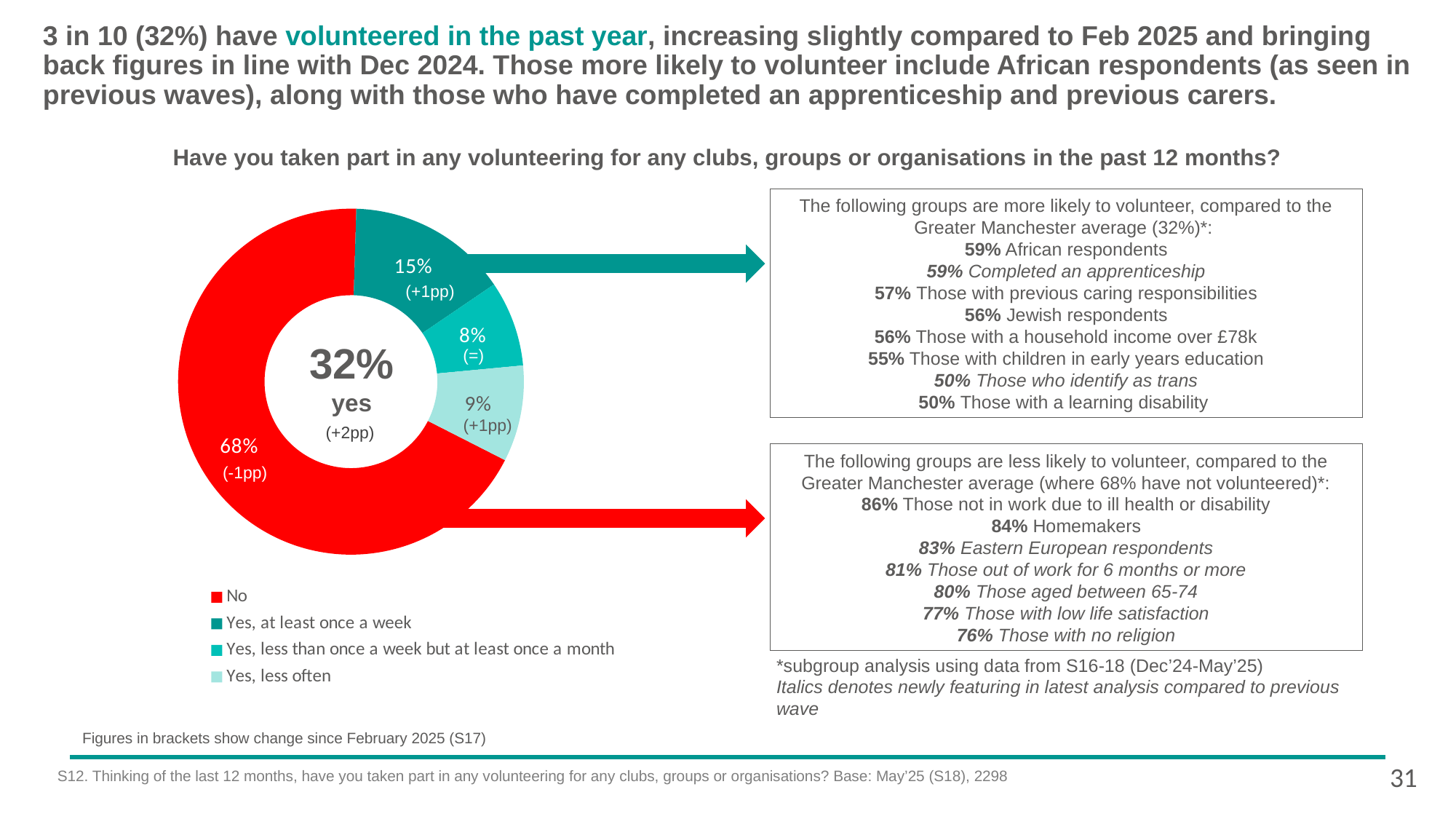
Which category has the smallest share of the donut chart? Yes, less than once a week but at least once a month What percentage of respondents answered "Yes, less often"? 9% What is the difference in percentage points between the "No" share and the "Yes, at least once a week" share? 53 percentage points How many categories does the legend of the donut chart list? 4 What percentage of respondents volunteer at least once a week? 15% What percentage of respondents volunteer less than once a week but at least once a month? 8% What type of chart is shown on the slide? Donut (pie) chart What change since February 2025 is shown in brackets for the "No" segment? -1pp What percentage of respondents answered "No" to taking part in volunteering in the past 12 months? 68% Which is larger: the share for "Yes, less often" or the share for "Yes, less than once a week but at least once a month"? Yes, less often What is the total percentage shown in the centre of the donut chart for those who said yes? 32% Which category has the largest share of the donut chart? No